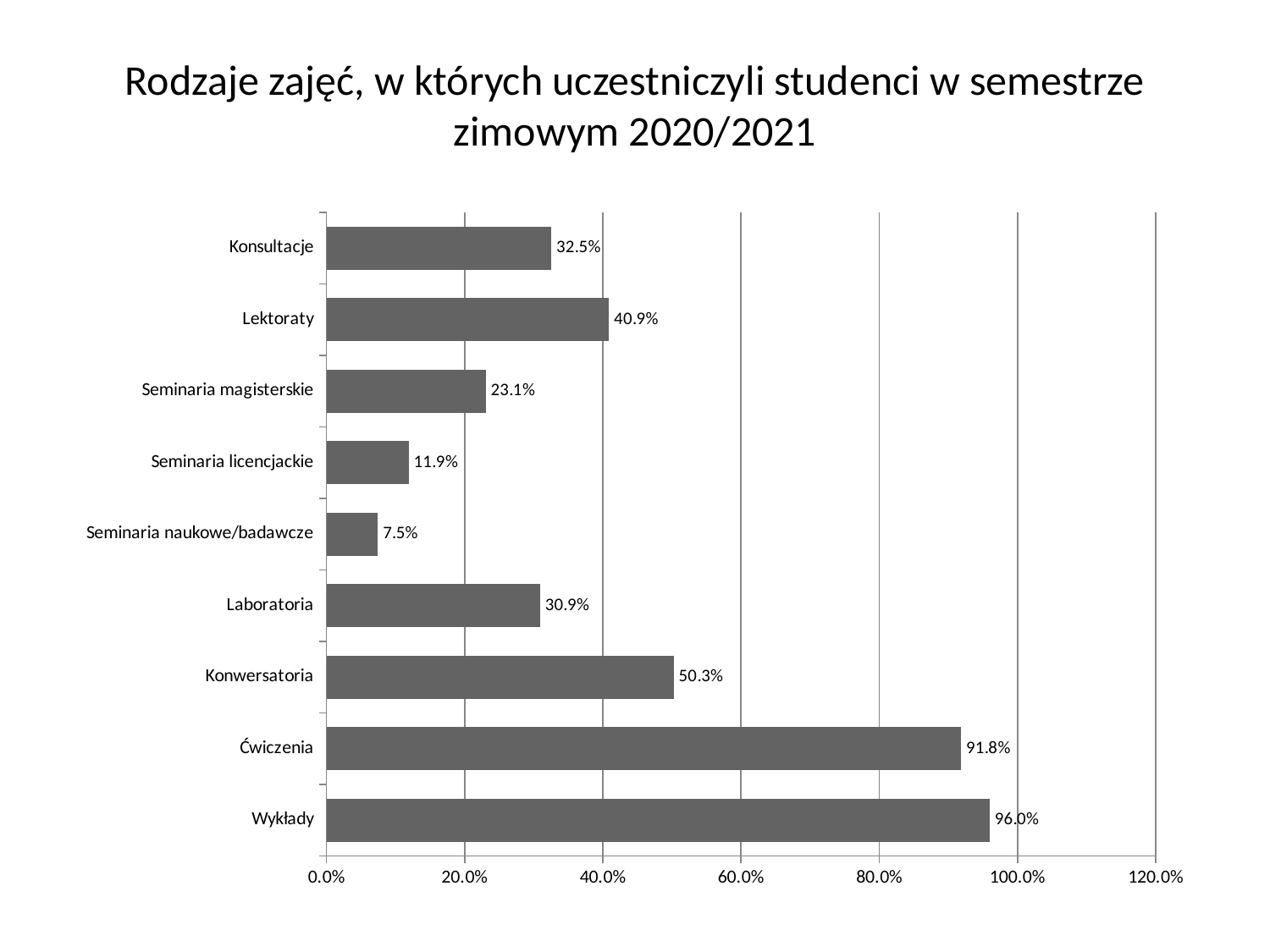
What is the difference between the values for Wykłady and Ćwiczenia? 4.2% Is the value for Konwersatoria greater or less than 40.0%? greater What is the value for Seminaria naukowe/badawcze? 7.5% Which category has the lowest value? Seminaria naukowe/badawcze What is the value for Konwersatoria? 50.3% What is the value for Wykłady? 96.0% Which is larger, the value for Laboratoria or the value for Seminaria magisterskie? Laboratoria What is the difference between the values for Lektoraty and Konsultacje? 8.4% What kind of chart is shown on the slide? bar chart What is the title of the chart? Rodzaje zajęć, w których uczestniczyli studenci w semestrze zimowym 2020/2021 Which category has the highest value? Wykłady How many categories are shown in the chart? 9